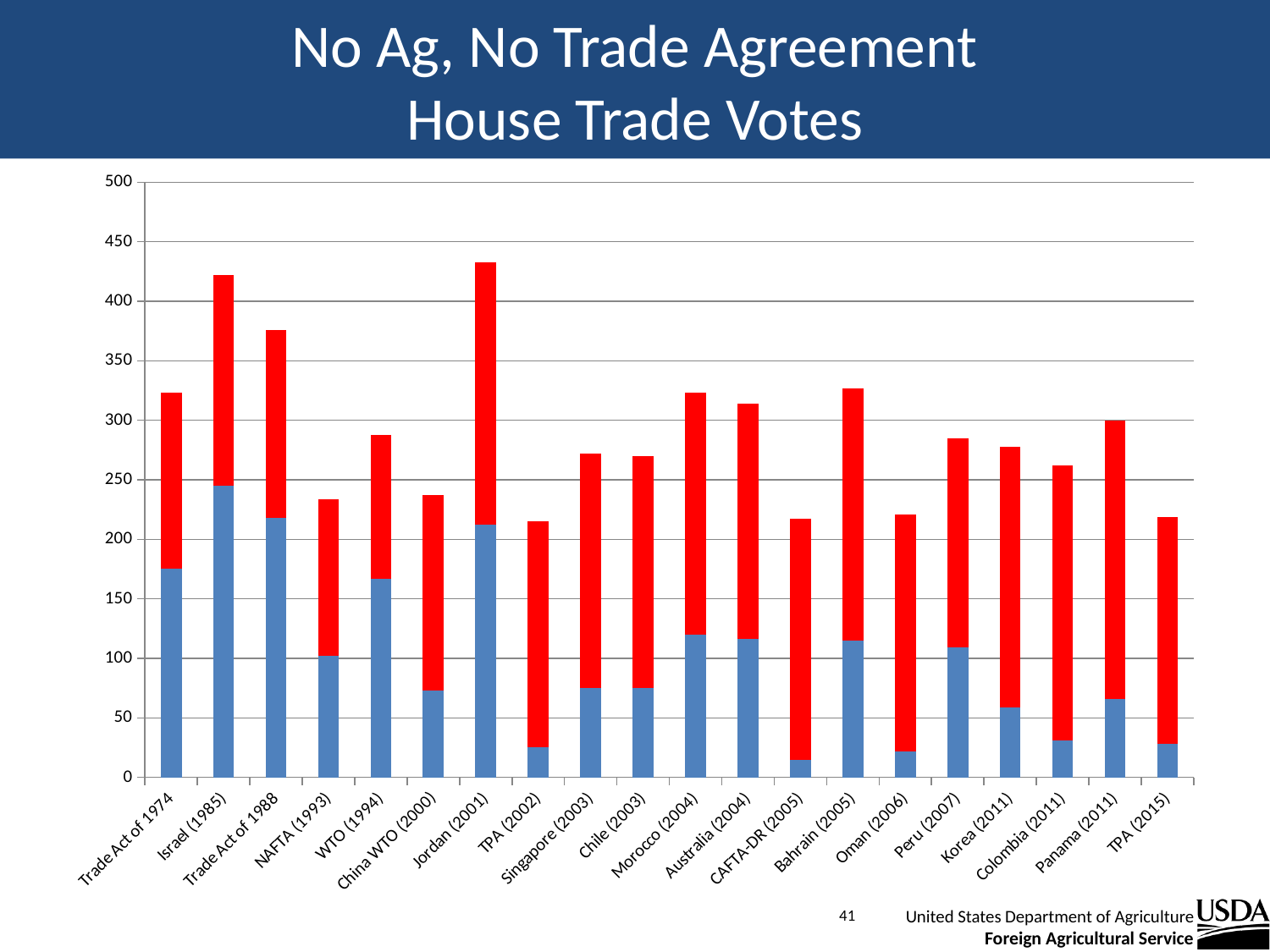
Which trade vote has the largest blue segment? Israel (1985) What two colours are used for the bar segments in the chart? Blue and red Is the total bar for Jordan (2001) greater or less than 400? greater Which has the larger blue segment, Morocco (2004) or Singapore (2003)? Morocco (2004) How many trade votes (categories) are shown on the x axis? 20 Which trade vote has the tallest total bar? Jordan (2001) Is the blue segment for Israel (1985) greater or less than 200? greater Is the total bar for NAFTA (1993) greater or less than 250? less What kind of chart is shown on the slide? Stacked bar chart Which has the taller total bar, Israel (1985) or Trade Act of 1988? Israel (1985)